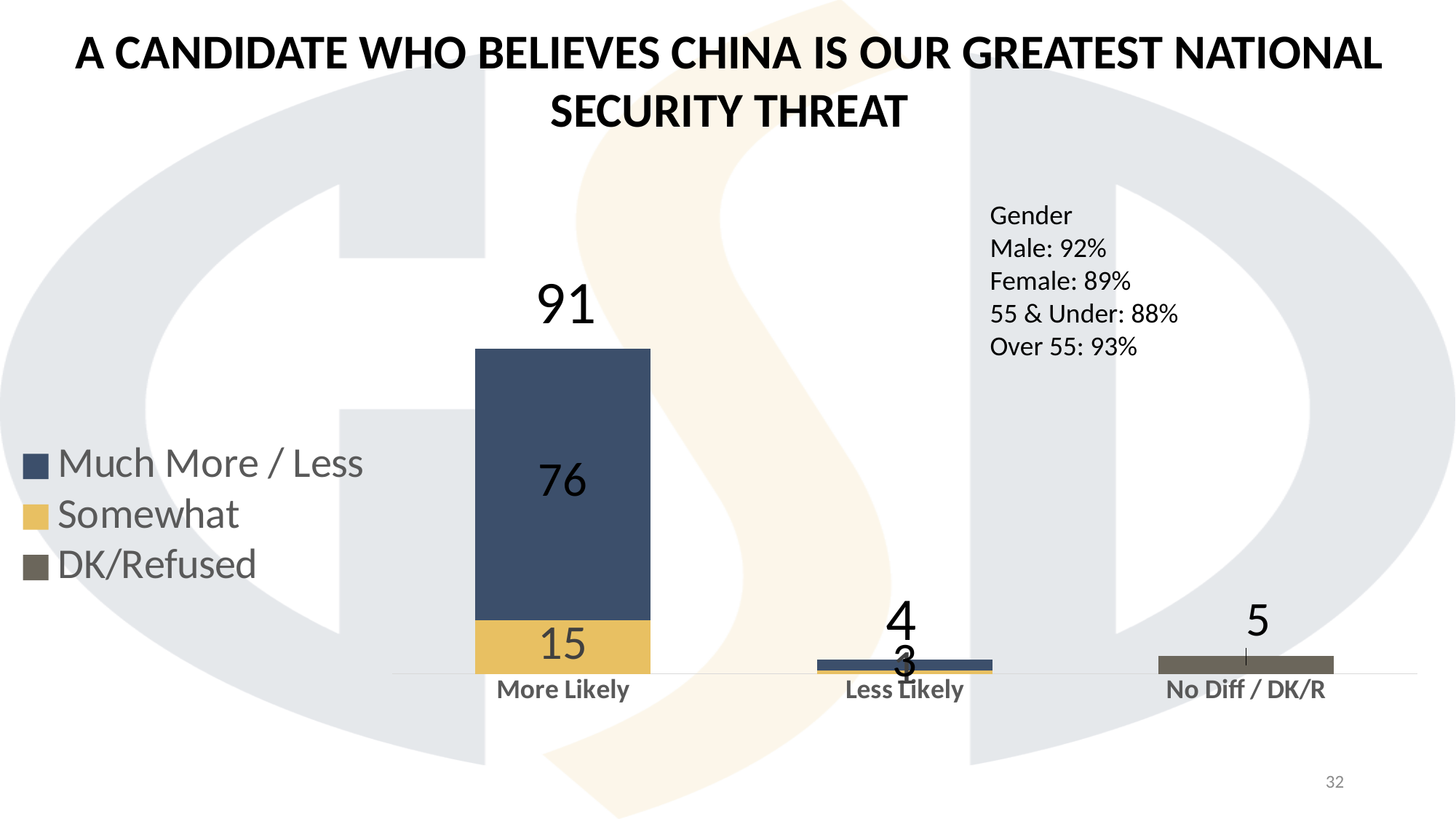
What is the difference between the Much More / Less value and the Somewhat value in the More Likely bar? 61 Which category has the lowest total? Less Likely What is the Somewhat value for the More Likely bar? 15 How many categories are shown on the x axis? 3 Which category has the highest total? More Likely What is the total shown above the More Likely bar? 91 What is the Much More / Less value for the More Likely bar? 76 How many series does the legend list? 3 What kind of chart is shown on the slide? Stacked bar chart What is the value shown for the No Diff / DK/R bar? 5 What is the total shown above the Less Likely bar? 4 Which is larger, the total for Less Likely or the total for No Diff / DK/R? No Diff / DK/R